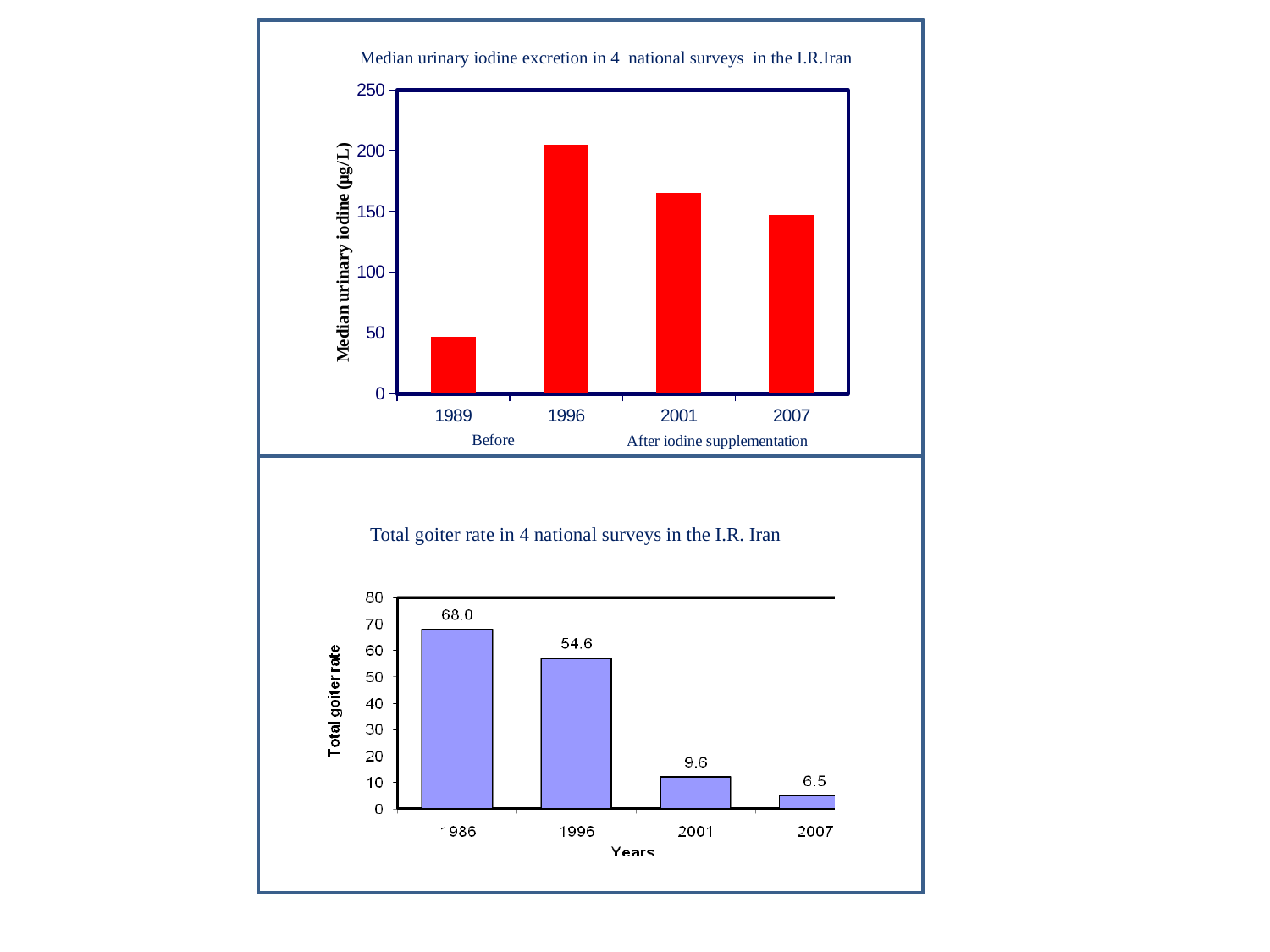
In the 'Total goiter rate' chart, which year has the highest total goiter rate? 1986 In the 'Median urinary iodine excretion' chart, which is larger, the value for 2001 or the value for 2007? 2001 In the 'Total goiter rate' chart, what is the value for 2007? 6.5 In the 'Total goiter rate' chart, what is the difference between the values for 1986 and 1996? 13.4 In the 'Total goiter rate' chart, what is the value for 2001? 9.6 In the 'Total goiter rate' chart, which year has the lowest total goiter rate? 2007 In the 'Median urinary iodine excretion' chart, which year has the highest median urinary iodine? 1996 What kind of chart is the 'Total goiter rate' chart? Bar chart In the 'Total goiter rate' chart, what is the value for 1986? 68.0 In the 'Median urinary iodine excretion' chart, which year has the lowest median urinary iodine? 1989